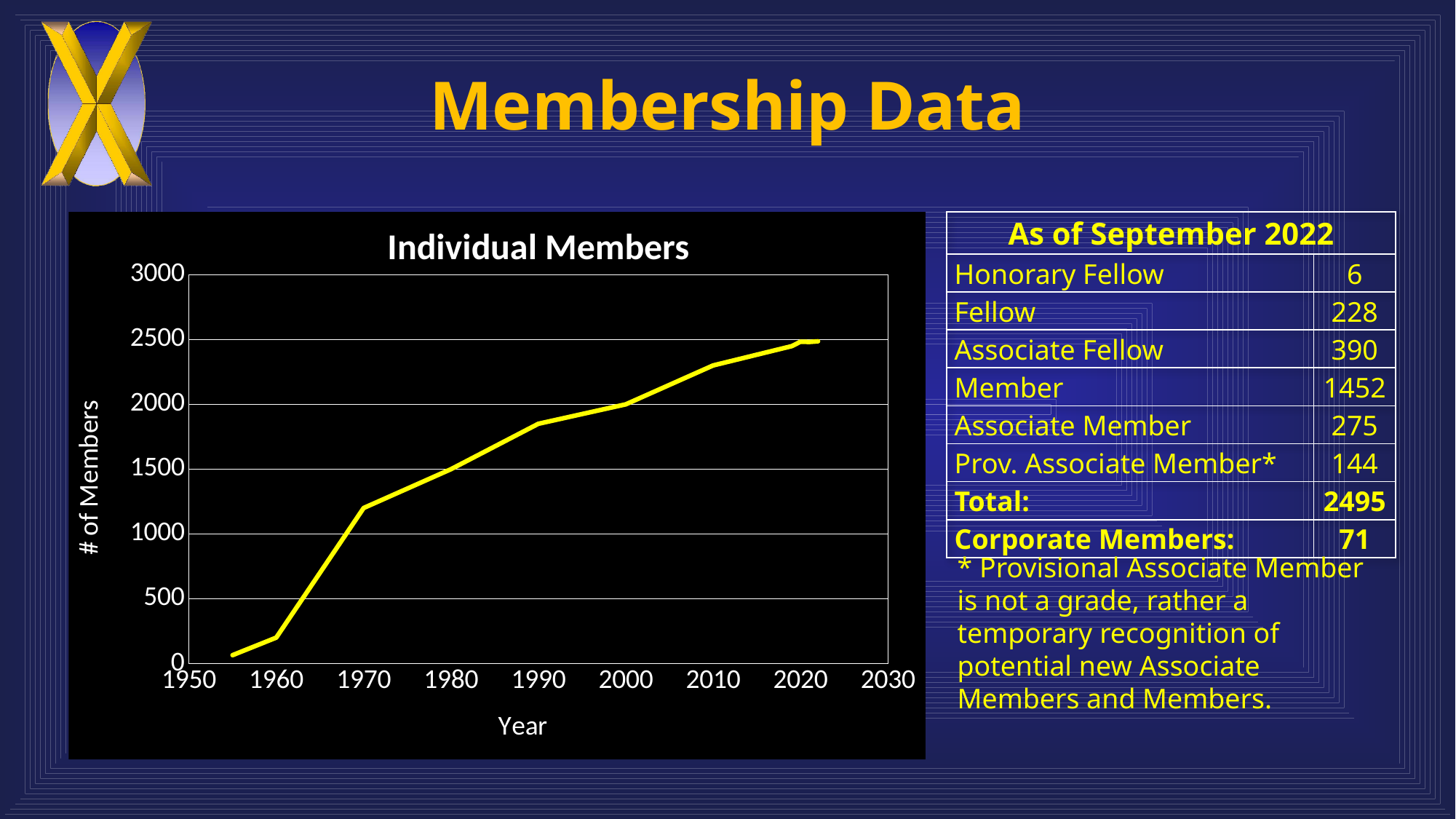
Is the value for 1970 in the Individual Members chart greater or less than 1500? less Is the value for 1990 in the Individual Members chart greater or less than 1500? greater Is the value for 1970 in the Individual Members chart greater or less than 1000? greater What kind of chart is shown on the slide? line chart Do the values in the Individual Members chart rise or fall as the year increases? rise What is the title of the chart? Individual Members What is the label of the y axis of the chart? # of Members In the Individual Members chart, which year has a higher value, 1960 or 1970? 1970 In the Individual Members chart, which year has a higher value, 1990 or 2010? 2010